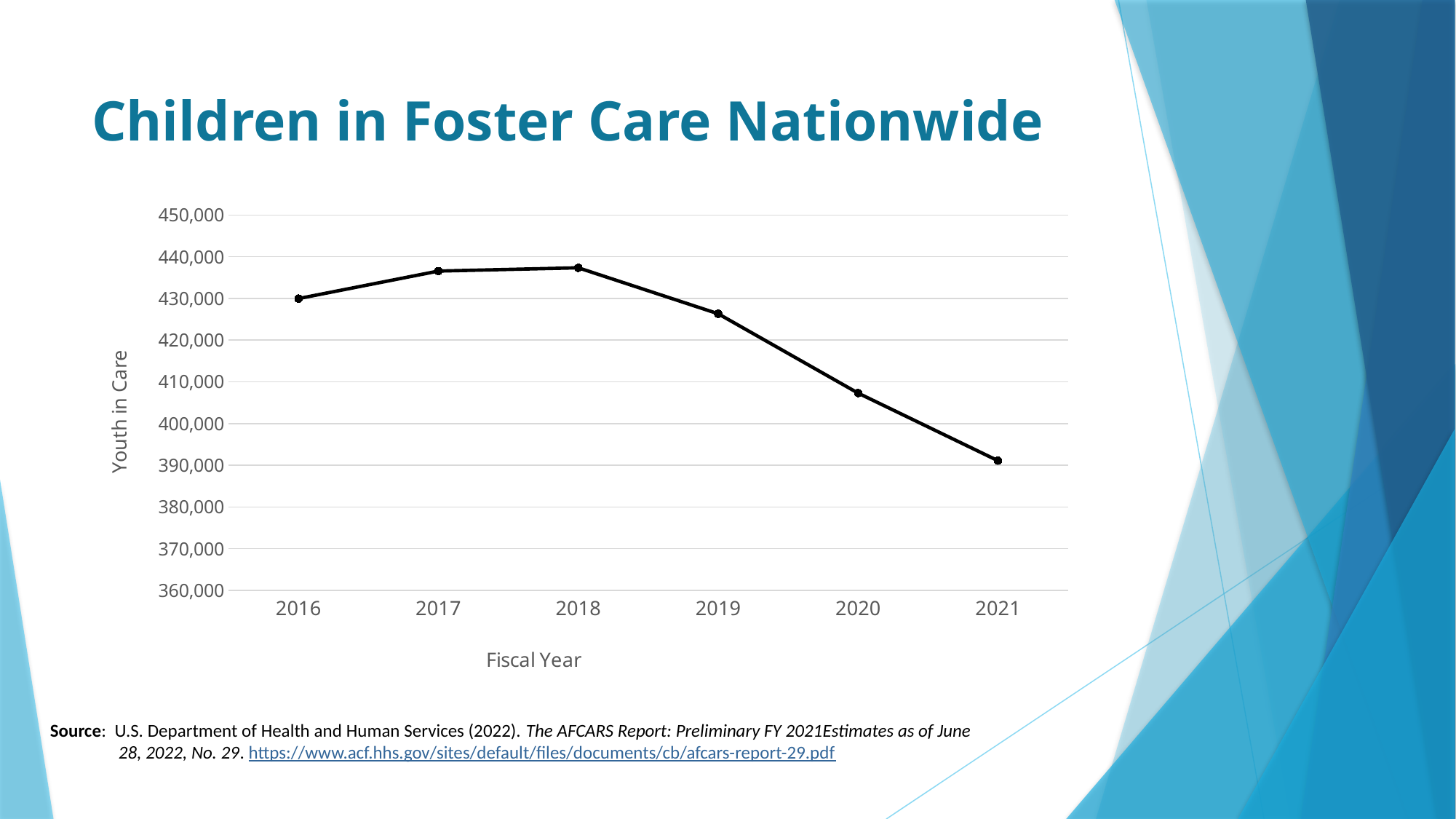
Which fiscal year has the lowest number of youth in care? 2021 Is the value for 2017 greater or less than 430,000? greater Is the value for 2021 greater or less than 400,000? less Which year has the larger value, 2016 or 2021? 2016 Is the value for 2018 greater or less than 440,000? less How many fiscal years are plotted on the chart? 6 What kind of chart is shown on the slide? line chart Which year has the larger value, 2019 or 2020? 2019 What is the label on the vertical axis of the chart? Youth in Care Do the values rise or fall from 2018 to 2021? fall